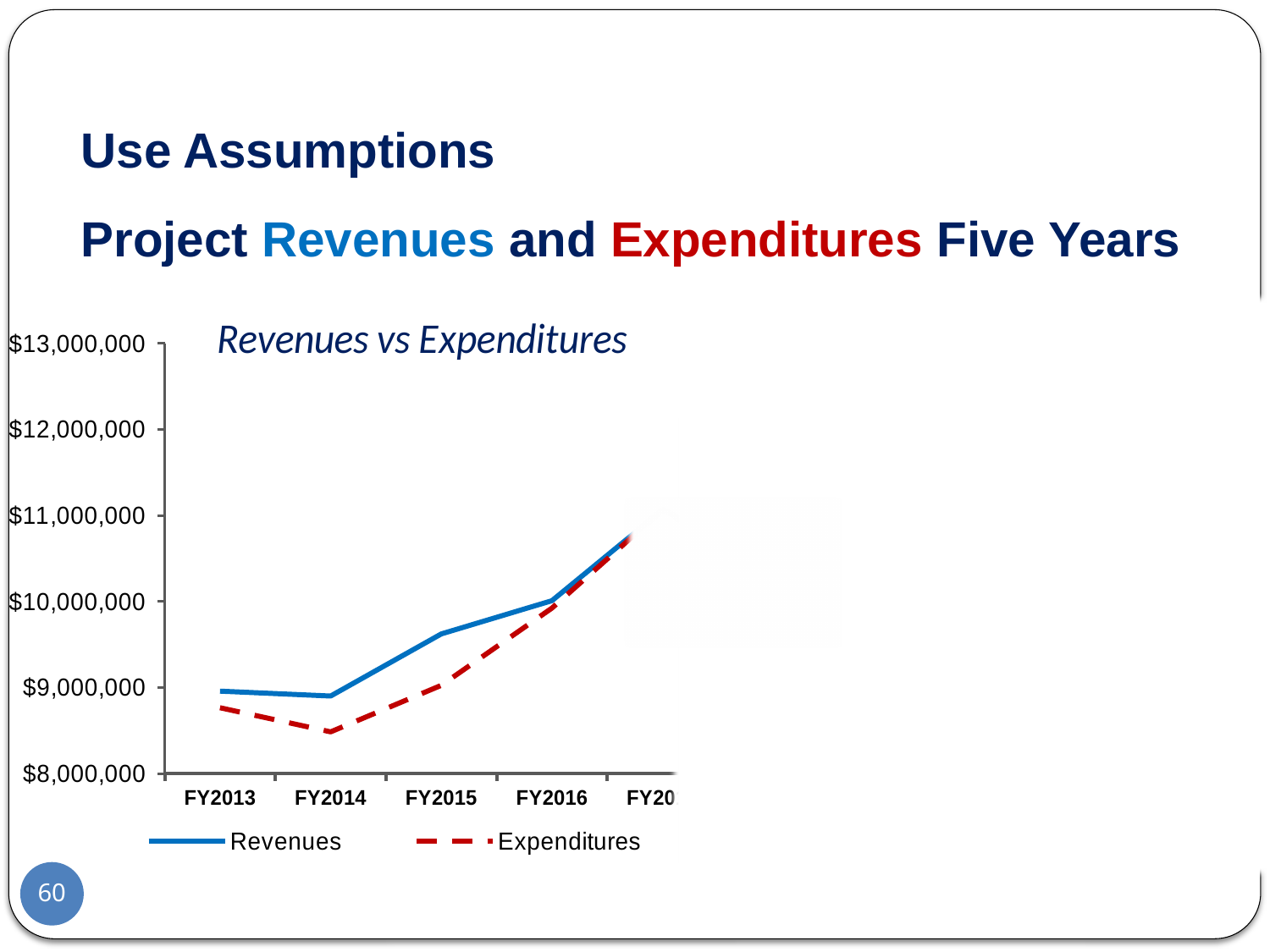
Do Expenditures rise or fall from FY2014 to FY2016? rise How many series does the legend of the chart list? 2 Is the value for Expenditures in FY2015 greater or less than $10,000,000? less In which fiscal year is the Expenditures line at its lowest? FY2014 What kind of chart is shown on the slide? line chart Is the value for Expenditures in FY2013 greater or less than $9,000,000? less Is the value for Revenues in FY2015 greater or less than $9,000,000? greater In FY2015, which is larger, Revenues or Expenditures? Revenues Which series is drawn with a dashed red line? Expenditures What is the title of the chart? Revenues vs Expenditures